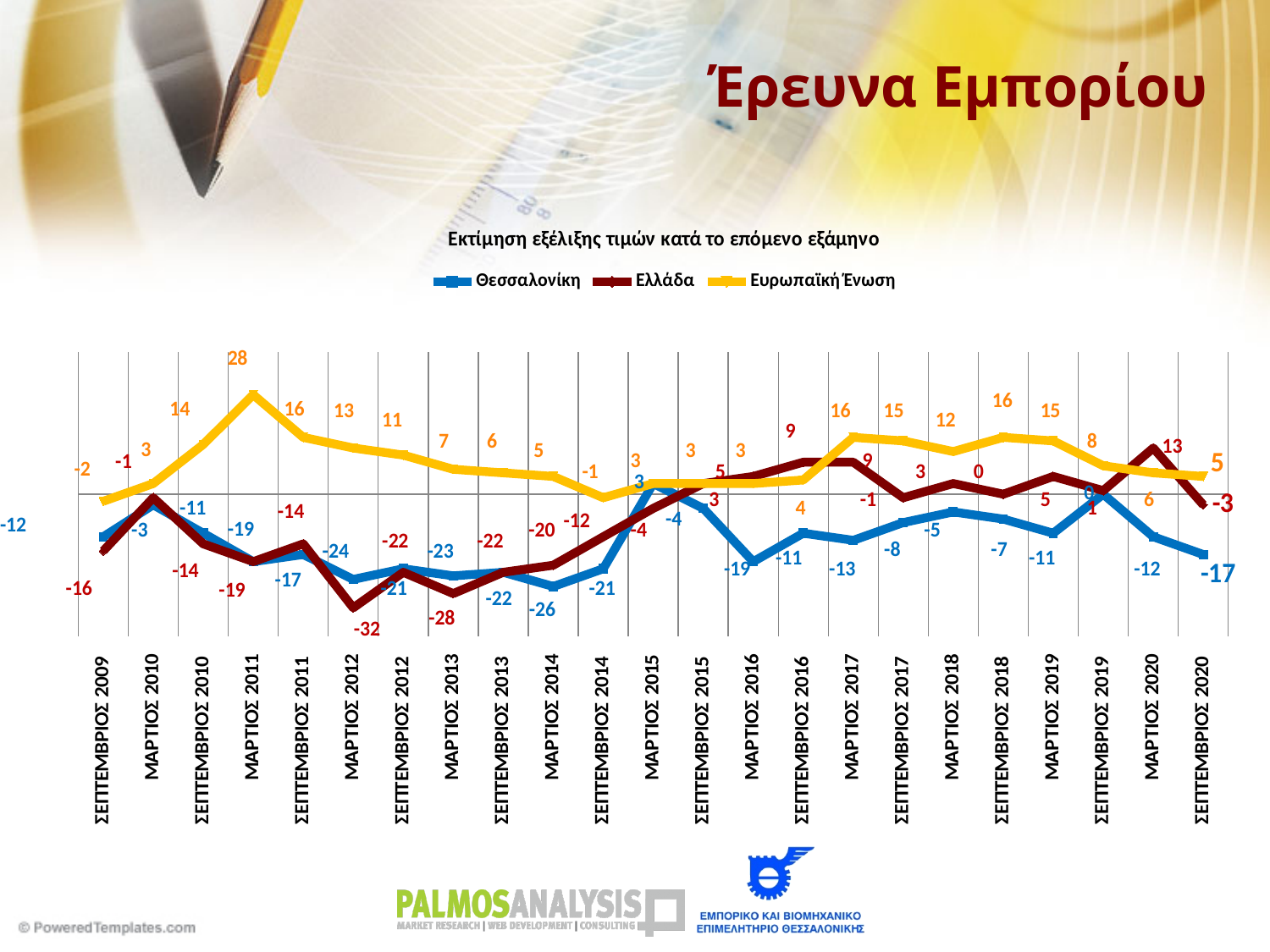
How many series does the legend list? 3 How many time points are shown along the x axis? 23 In ΣΕΠΤΕΜΒΡΙΟΣ 2020, which is larger: the value for Ευρωπαϊκή Ένωση or the value for Θεσσαλονίκη? Ευρωπαϊκή Ένωση What is the difference between the Θεσσαλονίκη values for ΜΑΡΤΙΟΣ 2020 and ΣΕΠΤΕΜΒΡΙΟΣ 2020? 5 What is the value for Ευρωπαϊκή Ένωση in ΜΑΡΤΙΟΣ 2011? 28 What is the value for Ελλάδα in ΜΑΡΤΙΟΣ 2012? -32 Does the Ευρωπαϊκή Ένωση series rise or fall from ΜΑΡΤΙΟΣ 2011 to ΣΕΠΤΕΜΒΡΙΟΣ 2014? fall What is the value for Θεσσαλονίκη in ΣΕΠΤΕΜΒΡΙΟΣ 2020? -17 At which time point does the Θεσσαλονίκη series reach its lowest value? ΜΑΡΤΙΟΣ 2014 At which time point does the Ευρωπαϊκή Ένωση series reach its highest value? ΜΑΡΤΙΟΣ 2011 What kind of chart is shown on the slide? line chart Which three series are listed in the legend? Θεσσαλονίκη, Ελλάδα, Ευρωπαϊκή Ένωση